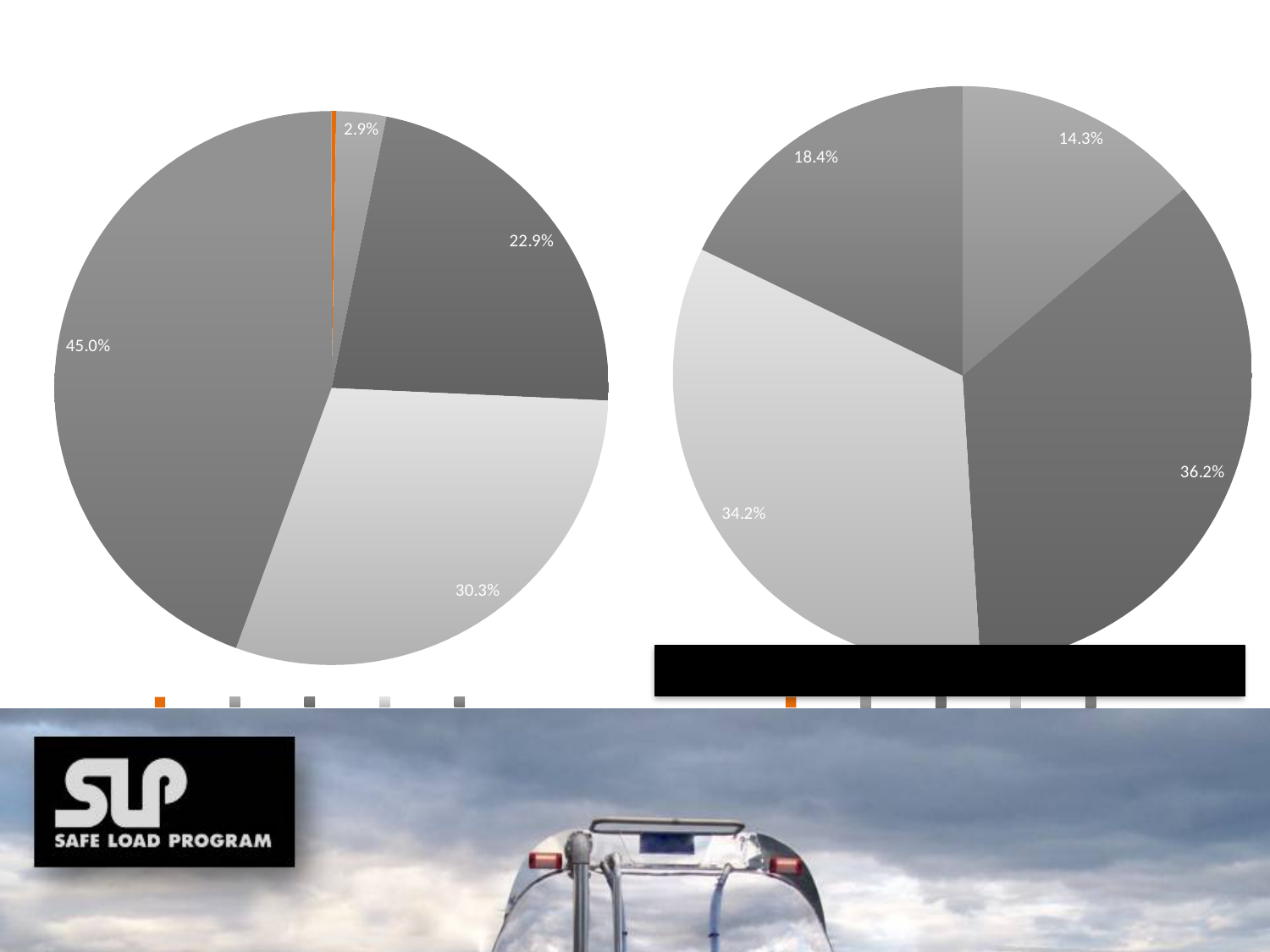
How many labelled slices does the right pie chart have? 4 In the left pie chart, what is the percentage of the largest slice? 45.0% In the right pie chart, what is the percentage of the largest slice? 36.2% What type of charts are shown on the slide? Pie charts In the right pie chart, what is the percentage of the smallest slice? 14.3% How many pie charts are on the slide? 2 In the left pie chart, what colour is the very thin slice at the top? Orange In the right pie chart, what is the difference between the 36.2% slice and the 34.2% slice? 2.0 percentage points In the left pie chart, what is the smallest labelled percentage? 2.9% Which chart has the larger biggest slice, the left pie chart or the right pie chart? The left pie chart In the left pie chart, what is the difference between the 45.0% slice and the 30.3% slice? 14.7 percentage points In the right pie chart, what share of the pie does the lightest grey slice represent? 34.2%